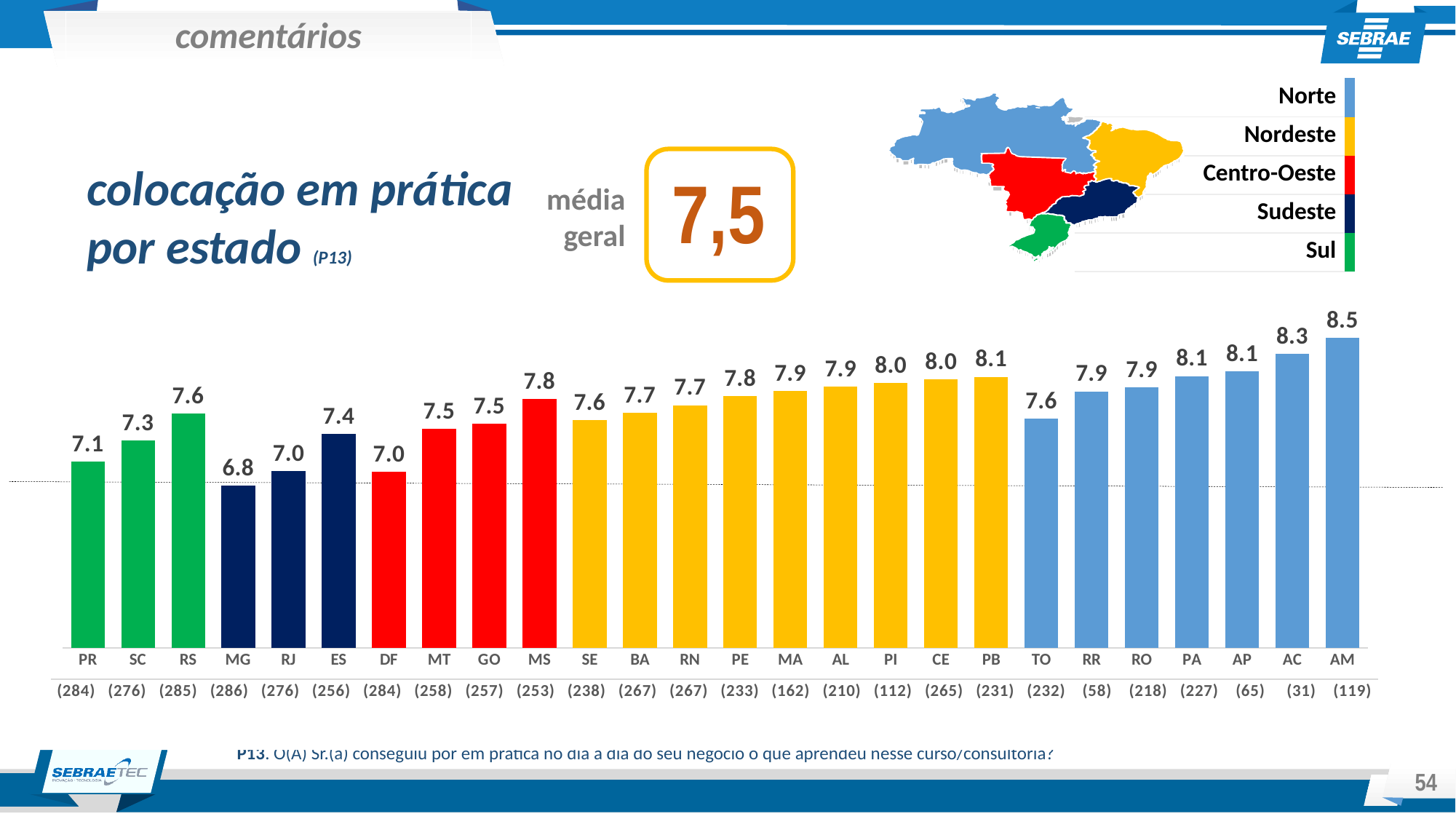
What is the value for MG? 6.8 What is the difference between the values for AM and MG? 1.7 What is the value for AM? 8.5 Which is larger, the value for RS or the value for SC? RS Which state has the highest value? AM Which state has the lowest value? MG What is the value for PB? 8.1 How many regions does the legend list? 5 What kind of chart is shown on the slide? bar chart How many states are shown on the chart? 26 What is the value for DF? 7.0 What is the difference between the values for AC and PR? 1.2